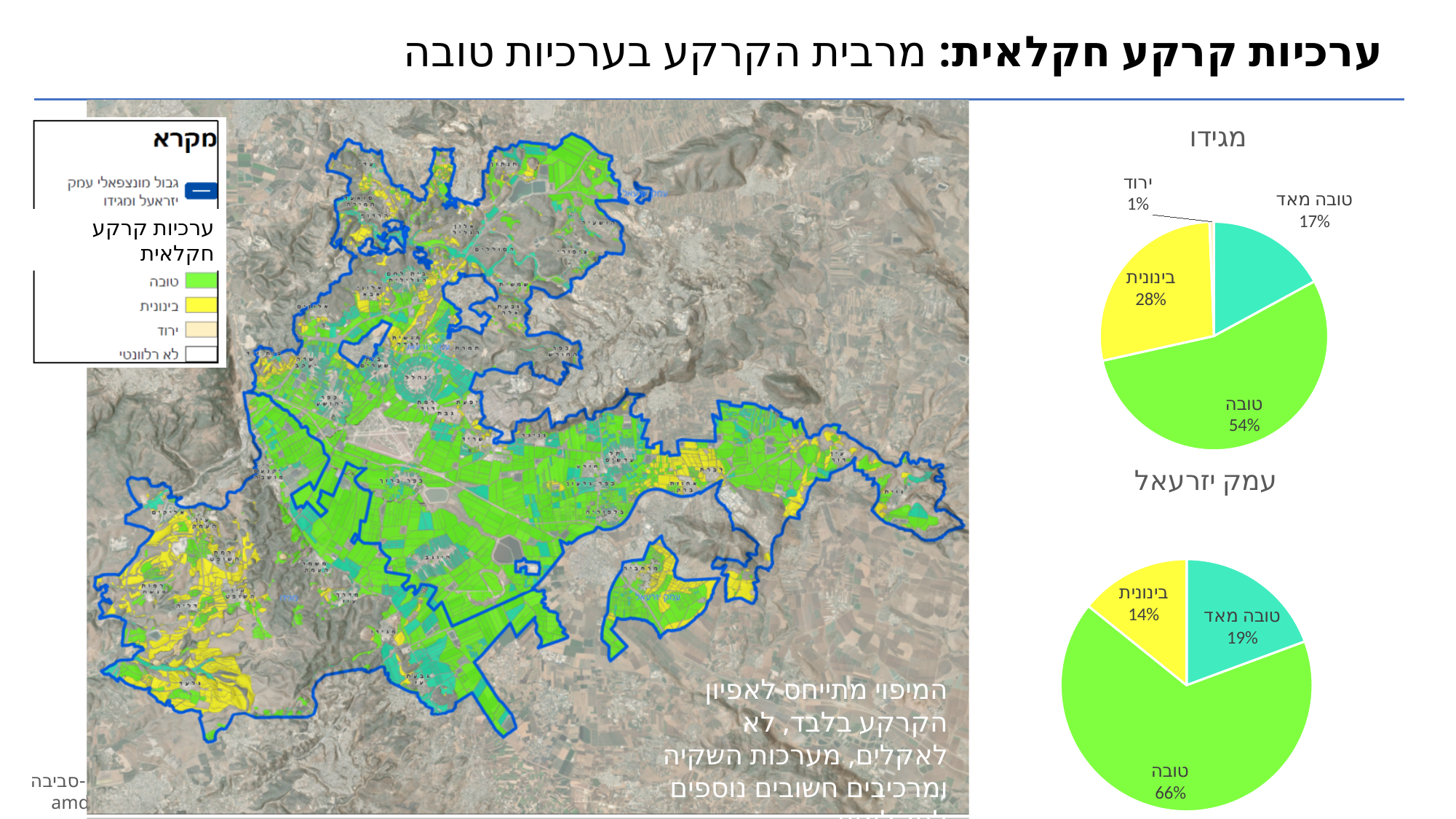
In the מגידו pie chart, what is the difference between the טובה and בינונית percentages? 26% In the מגידו pie chart, what percentage is labelled ירוד? 1% In the עמק יזרעאל pie chart, which is larger: טובה מאד or בינונית? טובה מאד In the מגידו pie chart, which category has the largest slice? טובה In the מגידו pie chart, which category has the smallest slice? ירוד In the עמק יזרעאל pie chart, what percentage is labelled טובה? 66% In the מגידו pie chart, what percentage is labelled טובה? 54% What type of chart is used for מגידו? Pie chart In the מגידו pie chart, what percentage is labelled בינונית? 28% How many slices does the עמק יזרעאל pie chart have? 3 In the עמק יזרעאל pie chart, which category has the smallest slice? בינונית In the עמק יזרעאל pie chart, what percentage is labelled טובה מאד? 19%